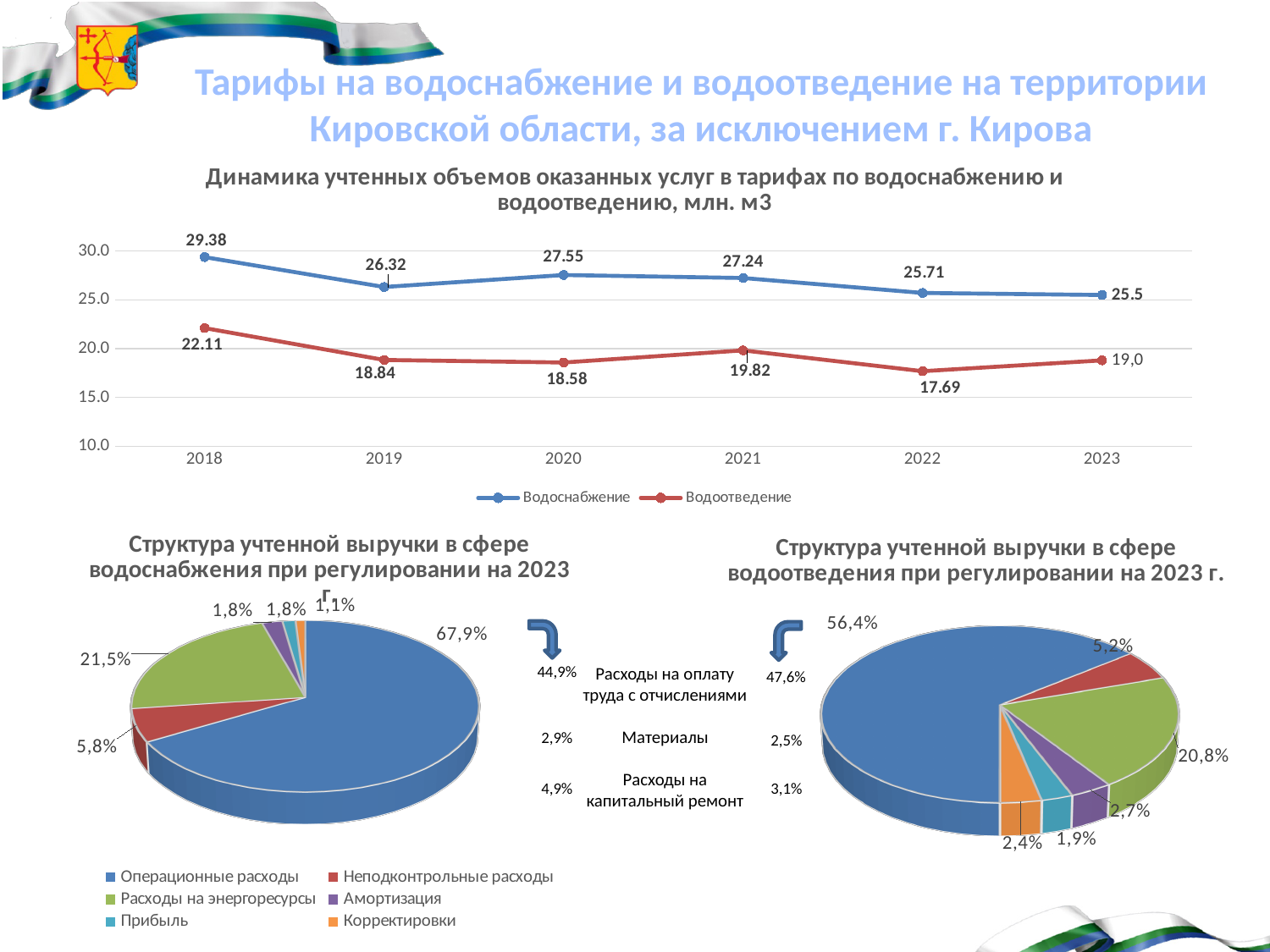
What kind of chart is the top chart 'Динамика учтенных объемов оказанных услуг'? Line chart In the line chart 'Динамика учтенных объемов оказанных услуг', which year has the highest value for Водоснабжение? 2018 In the line chart 'Динамика учтенных объемов оказанных услуг', what is the value for Водоснабжение in 2018? 29.38 In the line chart 'Динамика учтенных объемов оказанных услуг', which year has the lowest value for Водоотведение? 2022 In the line chart 'Динамика учтенных объемов оказанных услуг', what is the value for Водоотведение in 2022? 17.69 In the left pie chart 'Структура учтенной выручки в сфере водоснабжения', what is the share of the green slice (Расходы на энергоресурсы)? 21,5% In the right pie chart 'Структура учтенной выручки в сфере водоотведения', what is the share of the largest slice? 56,4% In the left pie chart 'Структура учтенной выручки в сфере водоснабжения', what share is labelled for the largest slice? 67,9% In the line chart 'Динамика учтенных объемов оказанных услуг', how many series does the legend list? 2 In the line chart 'Динамика учтенных объемов оказанных услуг', how many years are shown on the x axis? 6 In the line chart 'Динамика учтенных объемов оказанных услуг', what is the difference between Водоснабжение and Водоотведение in 2020? 8.97 Which is larger: the green slice in the left pie chart (21,5%) or the green slice in the right pie chart (20,8%)? The left pie chart (21,5%)